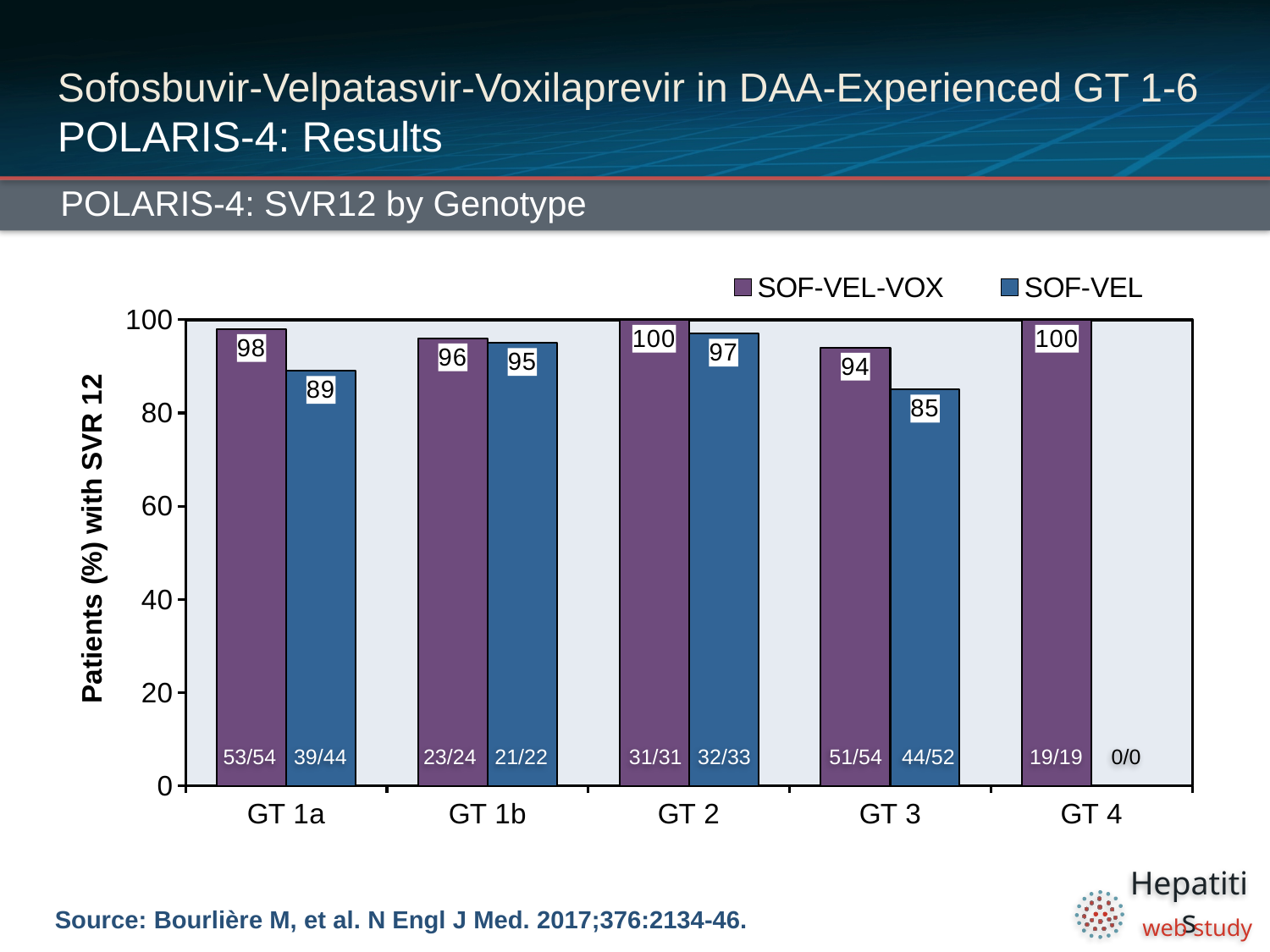
How many series does the legend list? 2 How many genotype categories are shown on the x axis? 5 What is the difference between the SOF-VEL-VOX and SOF-VEL SVR12 rates in GT 1a? 9 What is the SVR12 rate for SOF-VEL-VOX in GT 1a? 98 Which genotype has the lowest SVR12 rate for SOF-VEL? GT 3 Which is larger in GT 3, the SOF-VEL-VOX rate or the SOF-VEL rate? SOF-VEL-VOX What is the title of the chart? POLARIS-4: SVR12 by Genotype What is the SVR12 rate for SOF-VEL in GT 3? 85 What is the patient fraction shown for SOF-VEL-VOX in GT 3? 51/54 What is the SVR12 rate for SOF-VEL in GT 2? 97 What is the y-axis label of the chart? Patients (%) with SVR 12 What kind of chart is shown? Bar chart